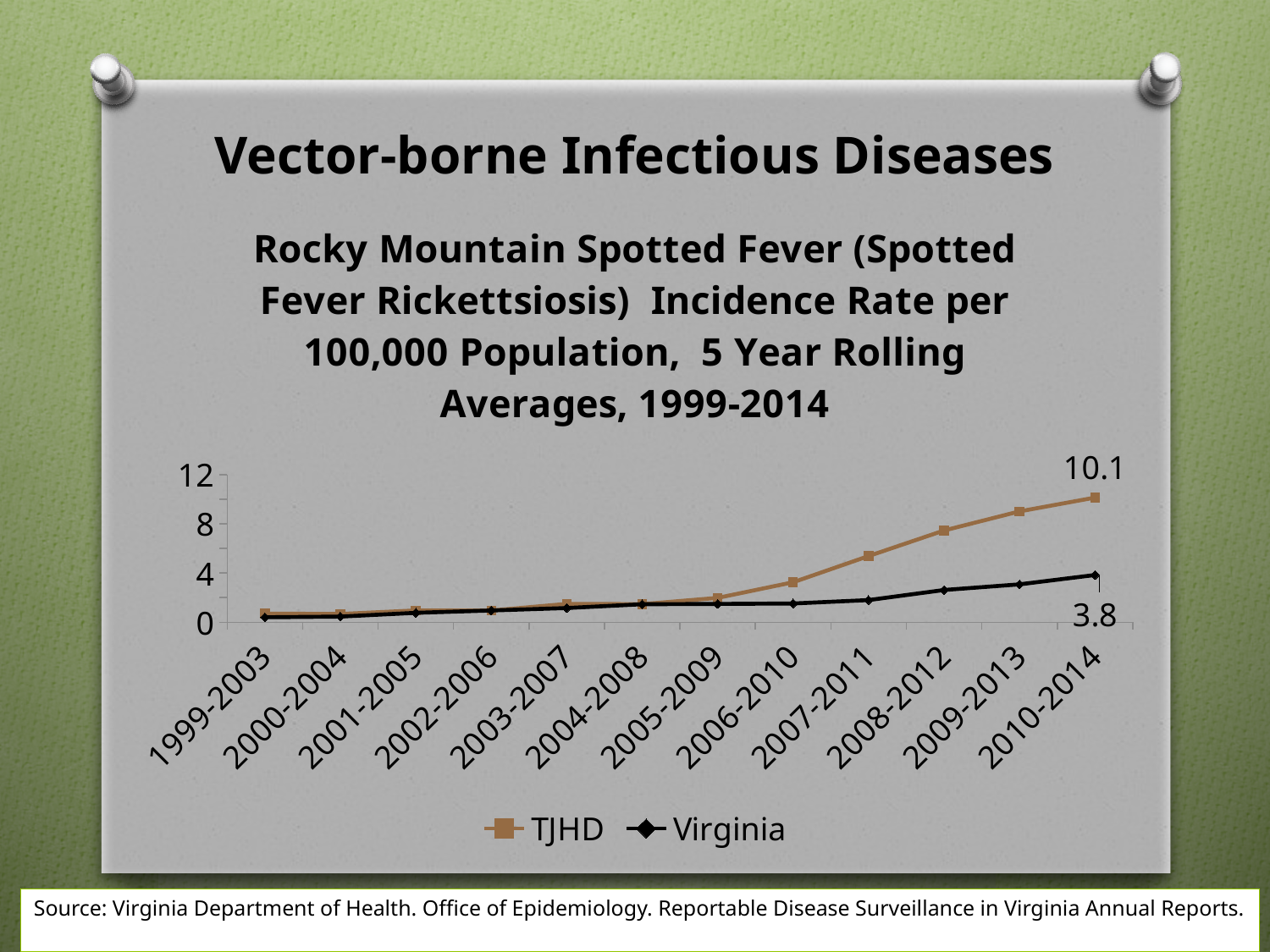
Which series is drawn in brown with square markers? TJHD Which series has the higher value for 2010-2014, TJHD or Virginia? TJHD What is the Virginia value for 2010-2014? 3.8 How many 5-year periods are shown on the x axis? 12 Does the TJHD series rise or fall from 1999-2003 to 2010-2014? Rise How many series does the legend list? 2 What is the difference between the TJHD and Virginia values for 2010-2014? 6.3 Is the TJHD value for 2009-2013 greater or less than 8? greater What is the TJHD value for 2010-2014? 10.1 What kind of chart is shown on the slide? Line chart Is the TJHD value for 2008-2012 greater or less than 4? greater Is the Virginia value for 2008-2012 greater or less than 4? less